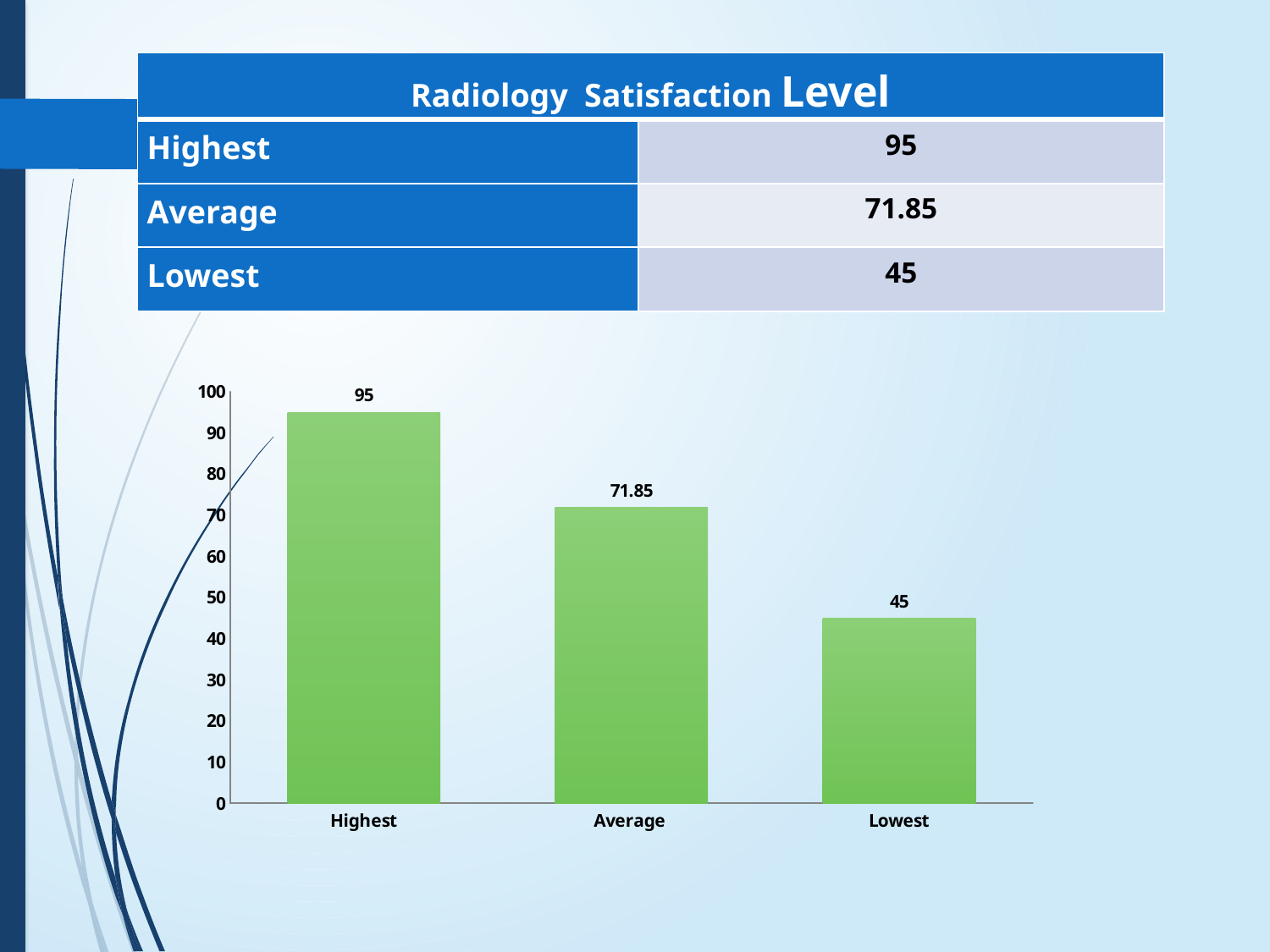
What is the value of the Highest bar? 95 Which is larger, the Average value or the Lowest value? Average Which category has the highest value? Highest What kind of chart is shown on the slide? bar chart What is the difference between the Highest and Lowest values? 50 How many bars are shown in the chart? 3 What is the value of the Lowest bar? 45 What is the value of the Average bar? 71.85 Do the values rise or fall from left to right along the x axis? fall Which category has the lowest value? Lowest Is the value for Average greater or less than 70? greater What is the difference between the Highest and Average values? 23.15